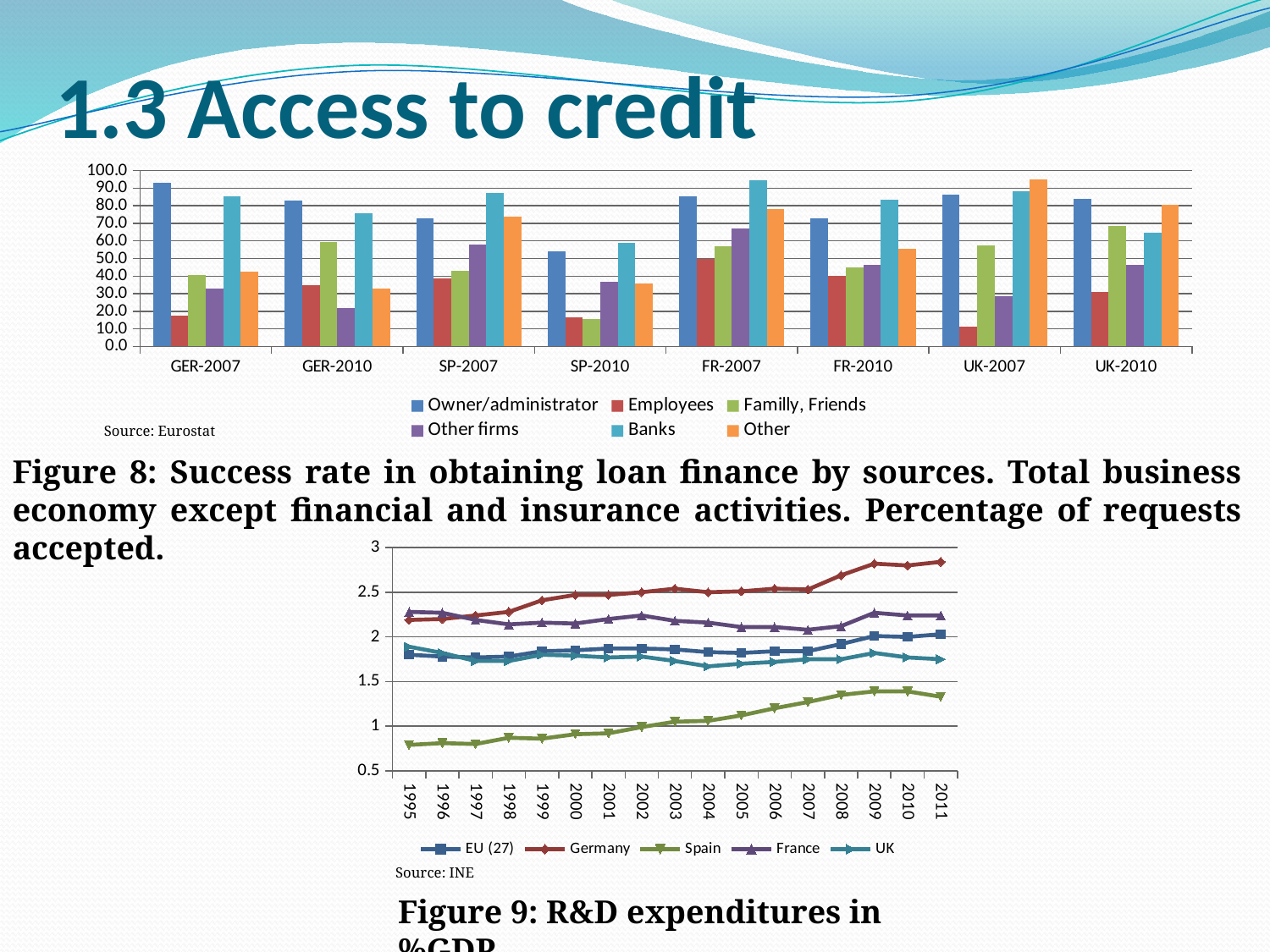
What kind of chart is the top chart (Figure 8)? bar chart In the bottom chart (Figure 9), which country has the highest R&D expenditure in 2011? Germany In the bottom chart (Figure 9), does the Spain line rise or fall from 1995 to 2009? rise In the top chart (Figure 8), is the Banks value for FR-2007 greater or less than 90.0? greater In the top chart (Figure 8), is the Employees value for UK-2007 greater or less than 20.0? less In the bottom chart (Figure 9), is the value for Germany in 2011 greater or less than 2.5? greater What kind of chart is the bottom chart (Figure 9)? line chart In the top chart (Figure 8), which is larger: the Owner/administrator value for GER-2007 or for SP-2010? GER-2007 In the bottom chart (Figure 9), how many series does the legend list? 5 In the top chart (Figure 8), how many country-year categories are shown on the x axis? 8 In the top chart (Figure 8), how many series does the legend list? 6 In the top chart (Figure 8), which category has the highest Other bar? UK-2007